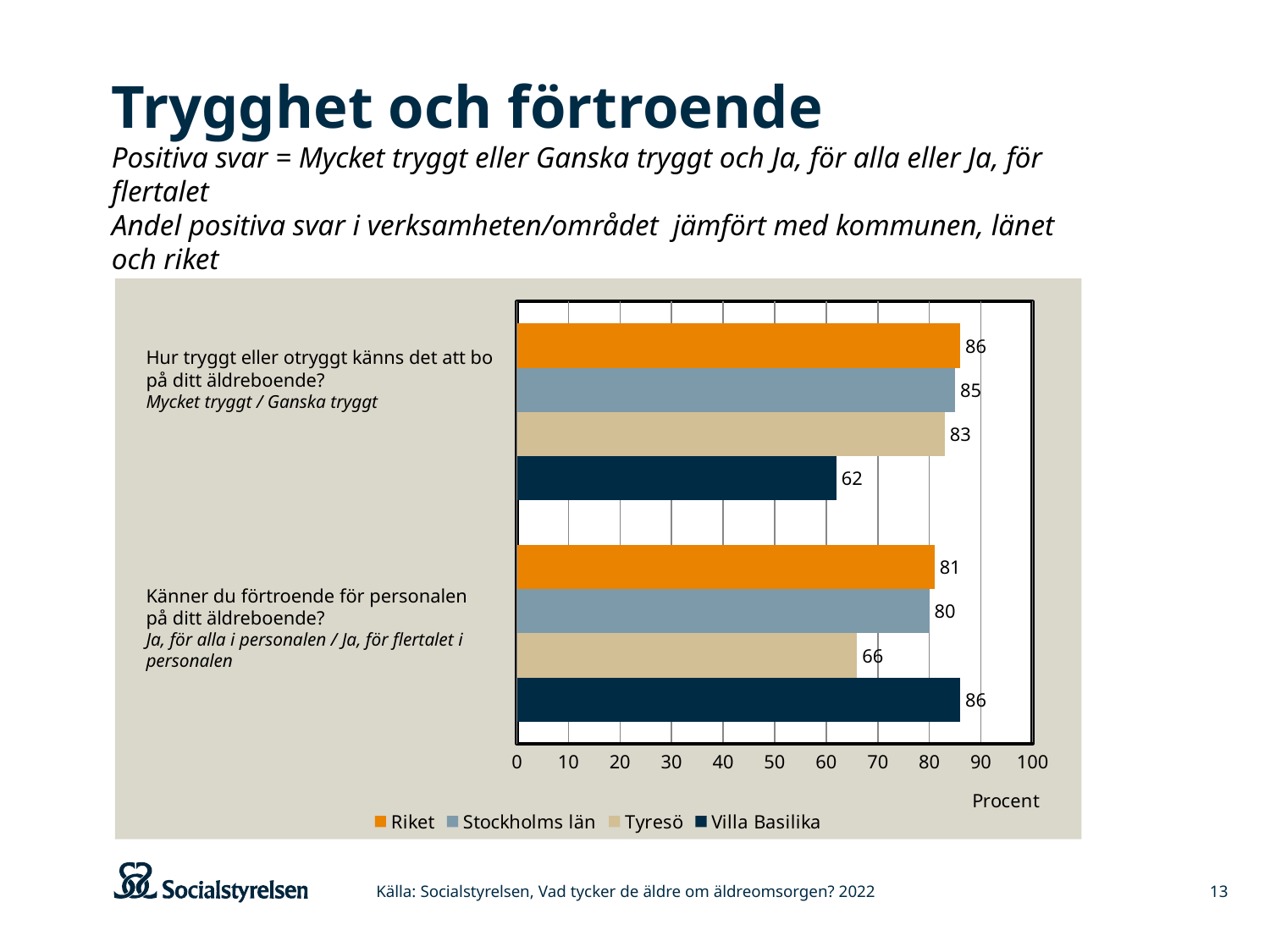
Which is larger on the question "Känner du förtroende för personalen på ditt äldreboende?": the value for Tyresö or the value for Riket? Riket What is the value for Riket on the question "Hur tryggt eller otryggt känns det att bo på ditt äldreboende?"? 86 How many series does the legend list? 4 What is the value for Stockholms län on the question "Känner du förtroende för personalen på ditt äldreboende?"? 80 What is the value for Villa Basilika on the question "Hur tryggt eller otryggt känns det att bo på ditt äldreboende?"? 62 What kind of chart is shown on the slide? Bar chart Which series has the lowest value on the question "Hur tryggt eller otryggt känns det att bo på ditt äldreboende?"? Villa Basilika What is the value for Tyresö on the question "Känner du förtroende för personalen på ditt äldreboende?"? 66 What unit label is shown below the x axis of the chart? Procent What is the difference between the Riket value and the Villa Basilika value on the question "Hur tryggt eller otryggt känns det att bo på ditt äldreboende?"? 24 How many question categories are shown on the chart? 2 Which series has the highest value on the question "Känner du förtroende för personalen på ditt äldreboende?"? Villa Basilika